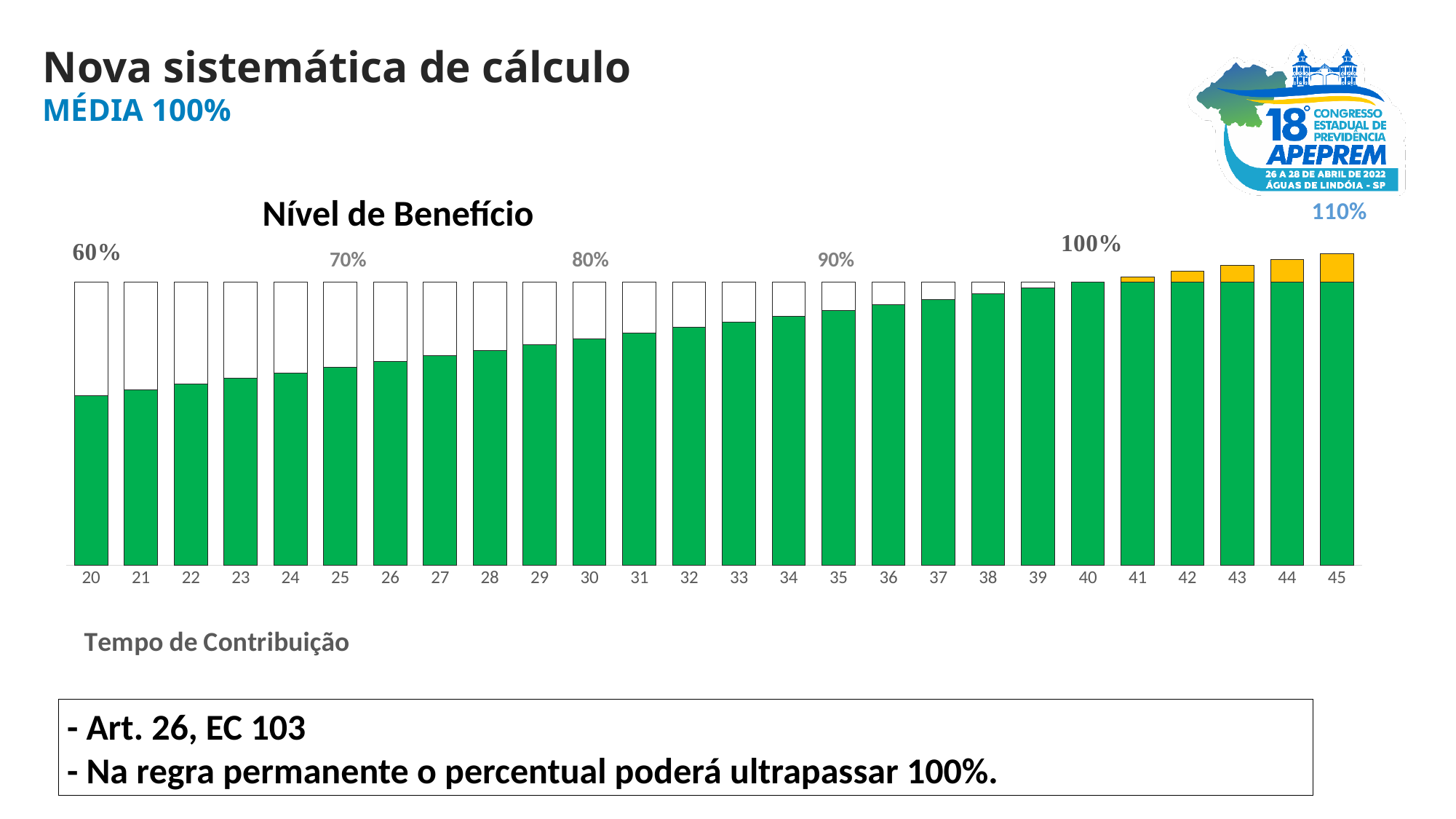
How many categories (contribution years) are shown along the x axis? 26 What is the title of the chart? Nível de Benefício How many bars have a yellow segment on top? 5 What is the last contribution time shown on the x axis? 45 Do the green bars rise or fall as the contribution time increases from 20 to 45? rise What kind of chart is shown on the slide? bar chart What is the label of the x axis of the chart? Tempo de Contribuição What is the first contribution time shown on the x axis? 20 Which contribution time has the shortest green bar? 20 Which has a taller green bar, contribution time 25 or contribution time 30? 30 Which has a taller green bar, contribution time 38 or contribution time 22? 38